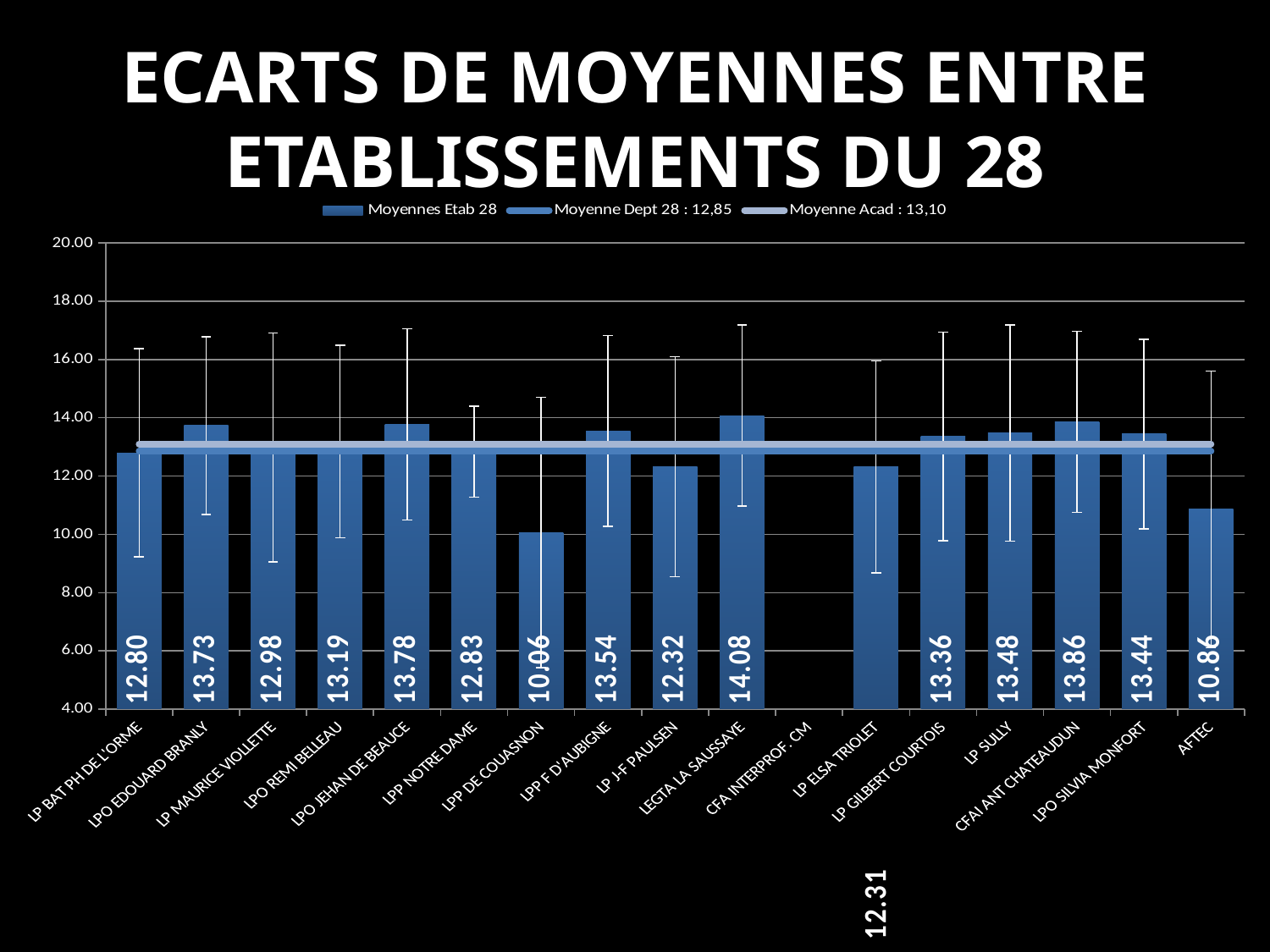
What is the value for CFAI ANT CHATEAUDUN? 13.86 What is the value for AFTEC? 10.86 How many establishments are listed on the x axis? 17 What value does the legend give for Moyenne Acad? 13,10 What is the value for LPP DE COUASNON? 10.06 How many entries does the legend list? 3 Which is larger, the value for LPO JEHAN DE BEAUCE or the value for LP J-F PAULSEN? LPO JEHAN DE BEAUCE What is the difference between the values for LEGTA LA SAUSSAYE and LPP DE COUASNON? 4.02 Which establishment has the lowest average? LPP DE COUASNON What is the value for LEGTA LA SAUSSAYE? 14.08 Is the value for LP ELSA TRIOLET greater or less than 14.00? less Which establishment has the highest average? LEGTA LA SAUSSAYE